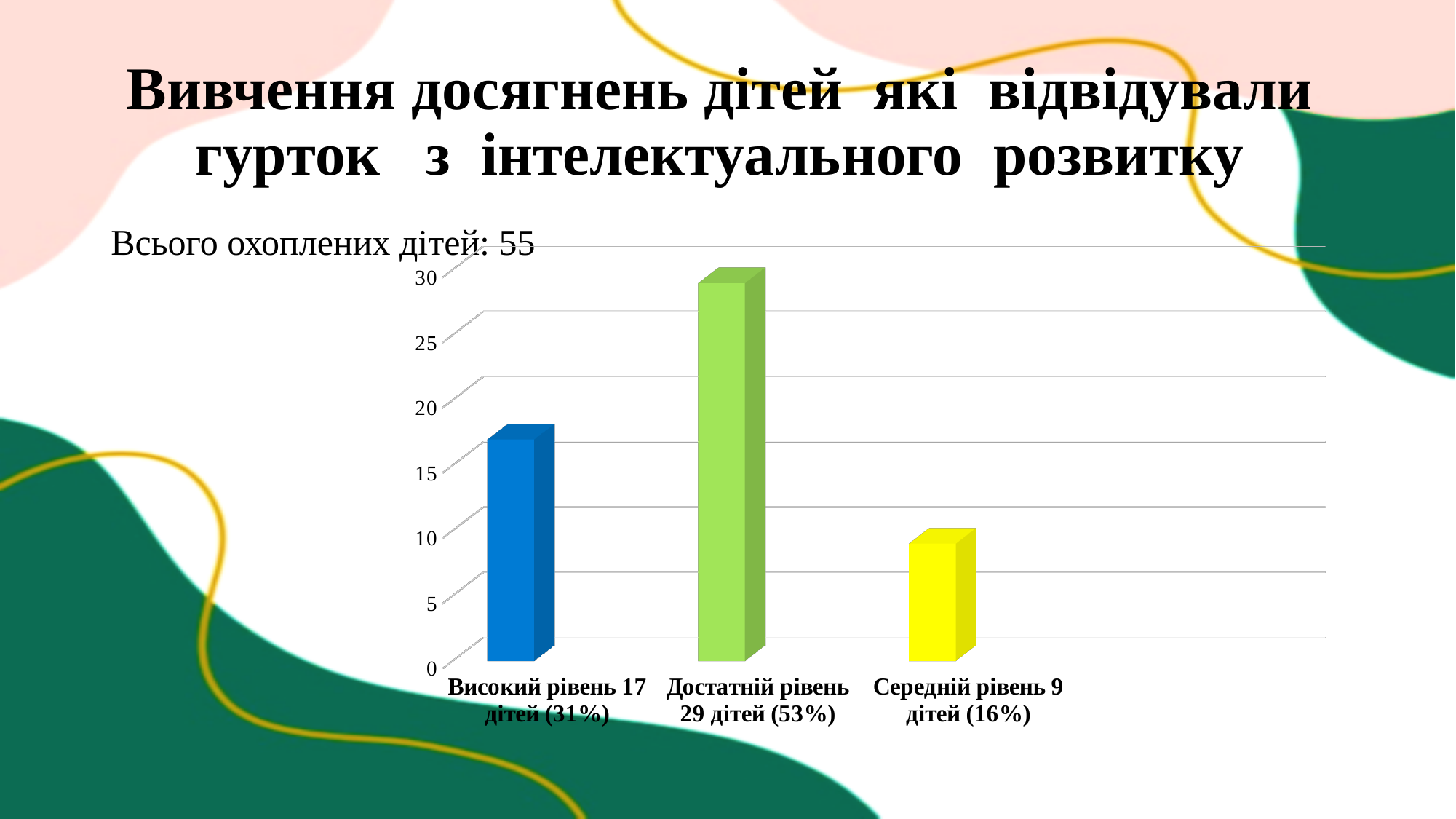
Is the value for Достатній рівень greater or less than 25? greater What percentage is shown for the sufficient level (Достатній рівень)? 53% Which level has the lowest number of children? Середній рівень Which level has the highest number of children? Достатній рівень How many children are at the medium level (Середній рівень) according to the category label? 9 Which has more children: the high level (Високий рівень) or the medium level (Середній рівень)? Високий рівень How many children are at the high level (Високий рівень) according to the category label? 17 How many categories (levels) are shown in the chart? 3 What is the difference in the number of children between the sufficient level (29) and the high level (17)? 12 What type of chart is shown on the slide? bar chart How many children are at the sufficient level (Достатній рівень) according to the category label? 29 What is the total number of children covered, as stated on the slide? 55